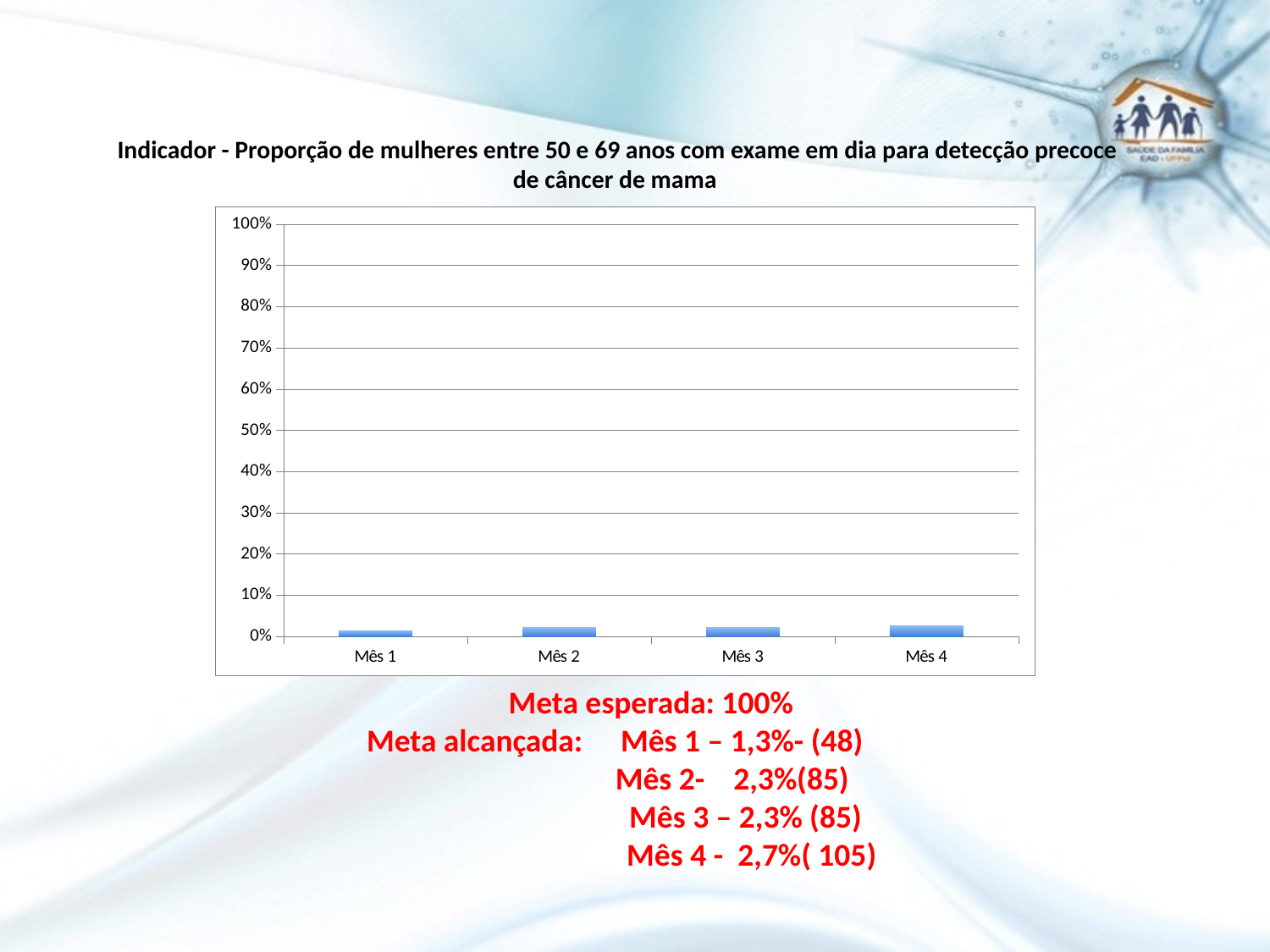
How many months (categories) are plotted on the x axis of the chart? 4 Which month has the lowest bar in the chart? Mês 1 Is the value for Mês 1 greater or less than 10%? less According to the text below the chart, what value was reached in Mês 4? 2,7% According to the text below the chart, what value was reached in Mês 1? 1,3% Which month has the highest bar in the chart? Mês 4 What is the expected target (Meta esperada) stated below the chart? 100% According to the text below the chart, what value was reached in Mês 2? 2,3% Which is larger, the value for Mês 1 or the value for Mês 4? Mês 4 Do the bar values generally rise or fall from Mês 1 to Mês 4? rise What kind of chart is shown on the slide? bar chart Is the value for Mês 4 greater or less than 10%? less